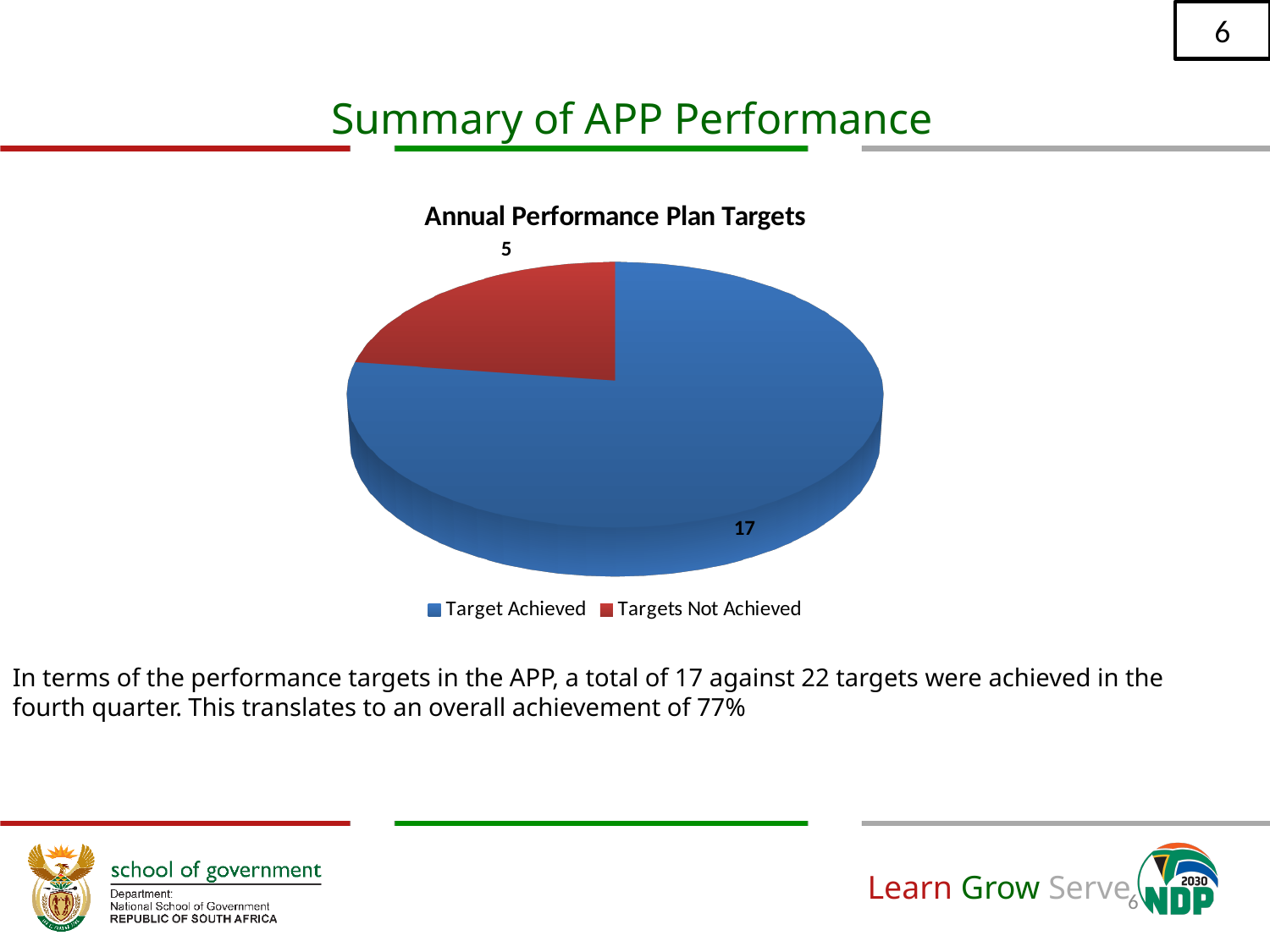
What is the title of the chart? Annual Performance Plan Targets How many slices does the pie chart have? 2 What is the difference between the Target Achieved and Targets Not Achieved values? 12 What is the value for Target Achieved? 17 What is the total of the two slices in the pie chart? 22 What is the value for Targets Not Achieved? 5 What kind of chart is shown on the slide? Pie chart How many entries does the legend list? 2 Which category has the largest slice of the pie? Target Achieved Which is larger, Target Achieved or Targets Not Achieved? Target Achieved Which category has the smallest slice of the pie? Targets Not Achieved What colour is the Targets Not Achieved slice? Red